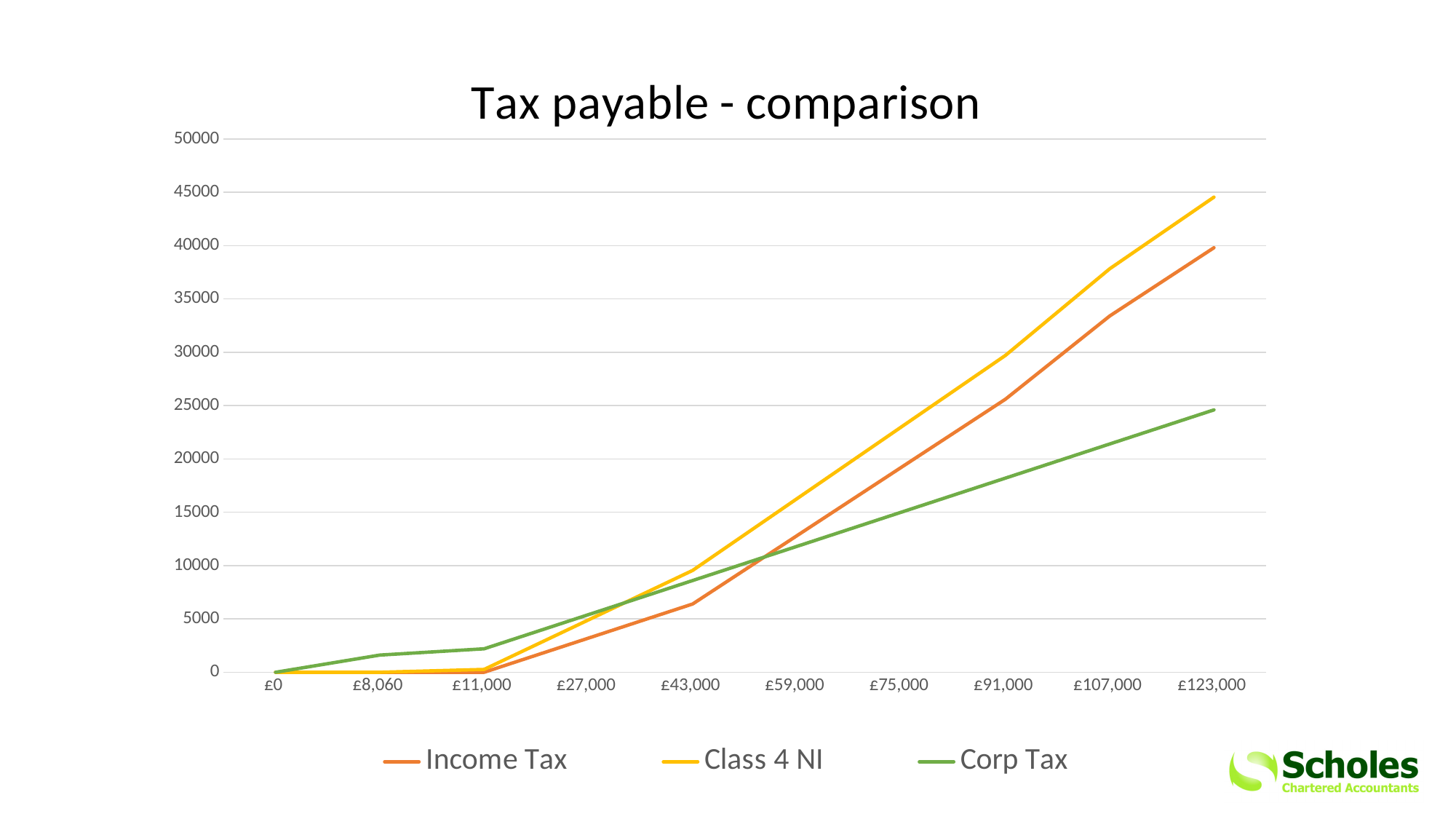
Does the Income Tax line rise or fall from £0 to £123,000? Rises Which series has the highest value at £123,000? Class 4 NI Which series has the lowest value at £123,000? Corp Tax What is the title of the chart? Tax payable - comparison Is the value for Corp Tax at £123,000 greater or less than 30000? less Is the value for Income Tax at £43,000 greater or less than 5000? greater How many categories are shown on the x axis? 10 What kind of chart is shown on the slide? Line chart At £43,000, which is larger: Class 4 NI or Income Tax? Class 4 NI How many series does the legend list? 3 Is the value for Class 4 NI at £123,000 greater or less than 40000? greater Which series has the highest value at £27,000? Corp Tax